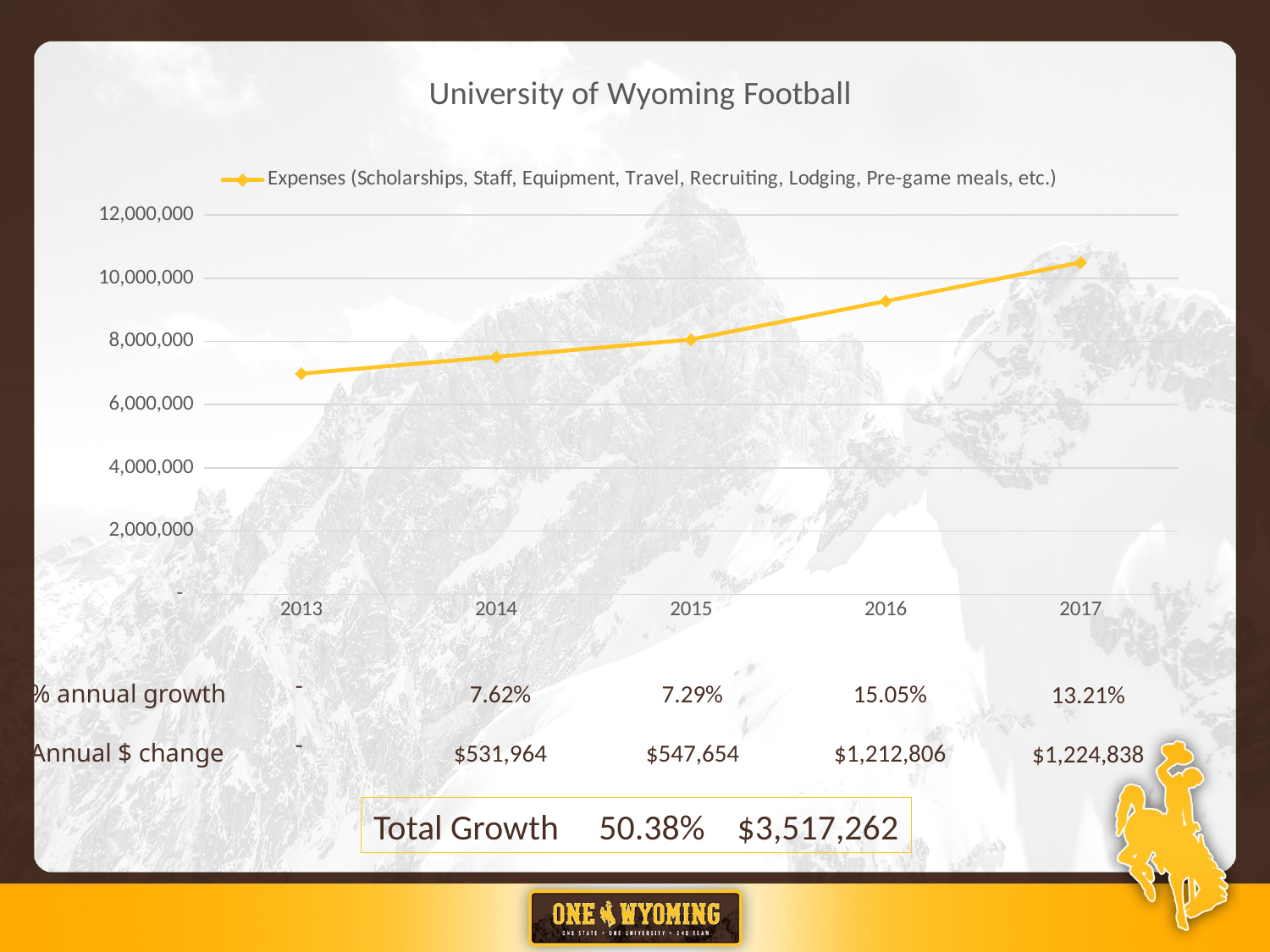
Is the expenses value for 2014 greater or less than 6,000,000? greater How many years are plotted on the x axis of the chart? 5 Which year has the highest expenses value on the chart? 2017 Is the expenses value for 2017 greater or less than 10,000,000? greater Is the expenses value for 2013 greater or less than 8,000,000? less How many series does the chart's legend list? 1 Do the expenses rise or fall from 2013 to 2017? rise What is the % annual growth shown for 2016? 15.05% What kind of chart is shown on the slide? line chart What is the Annual $ change shown for 2014? $531,964 Which year has the lowest expenses value on the chart? 2013